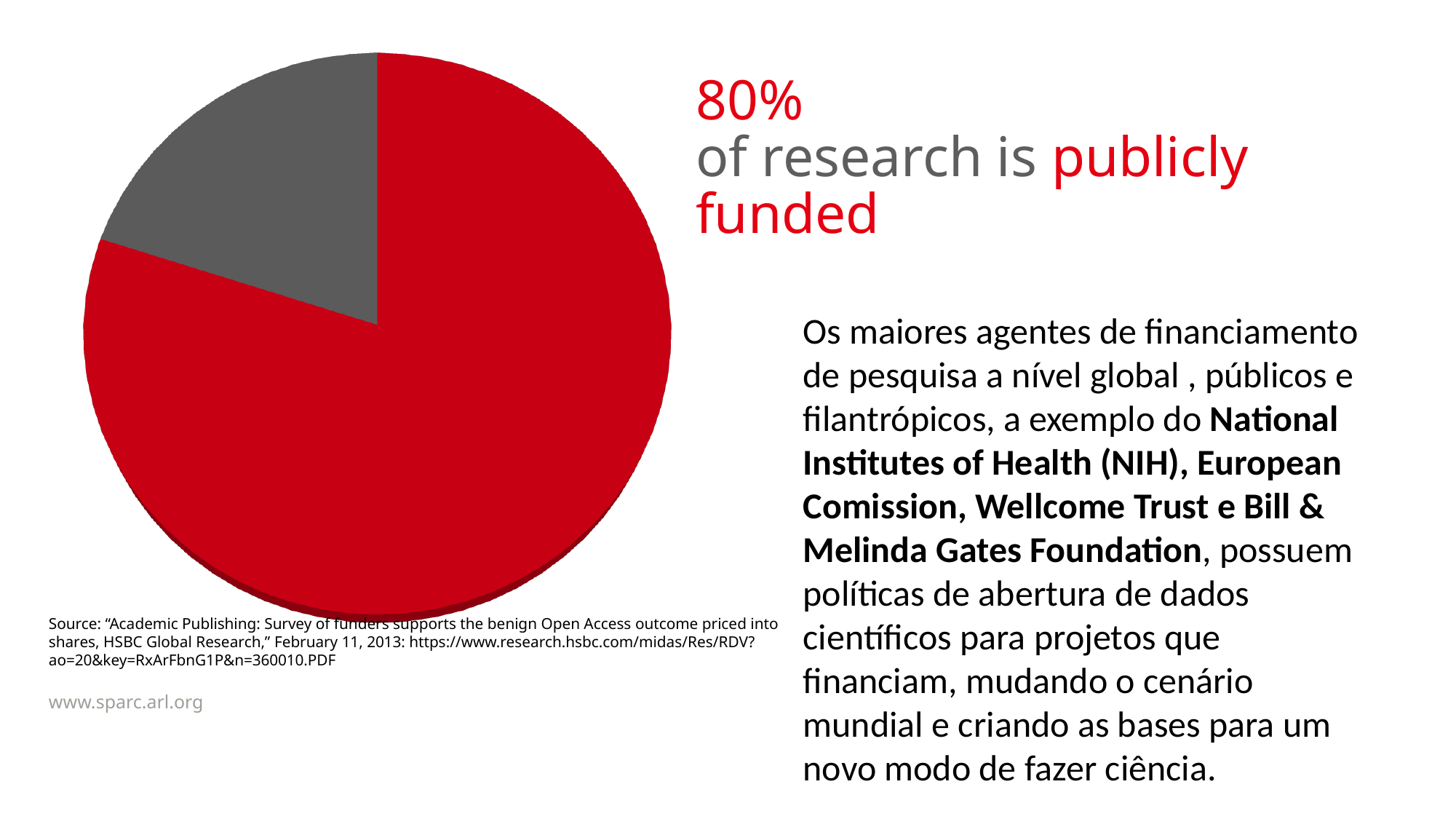
How many slices does the pie chart have? 2 What colour is the slice representing publicly funded research? red What does the red slice of the pie chart represent, according to the headline next to it? publicly funded research What share of research does the red slice of the pie chart represent, according to the slide? 80% Which slice of the pie chart is the smallest? the grey slice Which slice of the pie chart is the largest? the red slice (publicly funded research) What kind of chart is shown on the slide? pie chart Is the red slice or the grey slice of the pie chart larger? the red slice What share of the pie does the grey slice represent, given the red slice is 80%? 20%